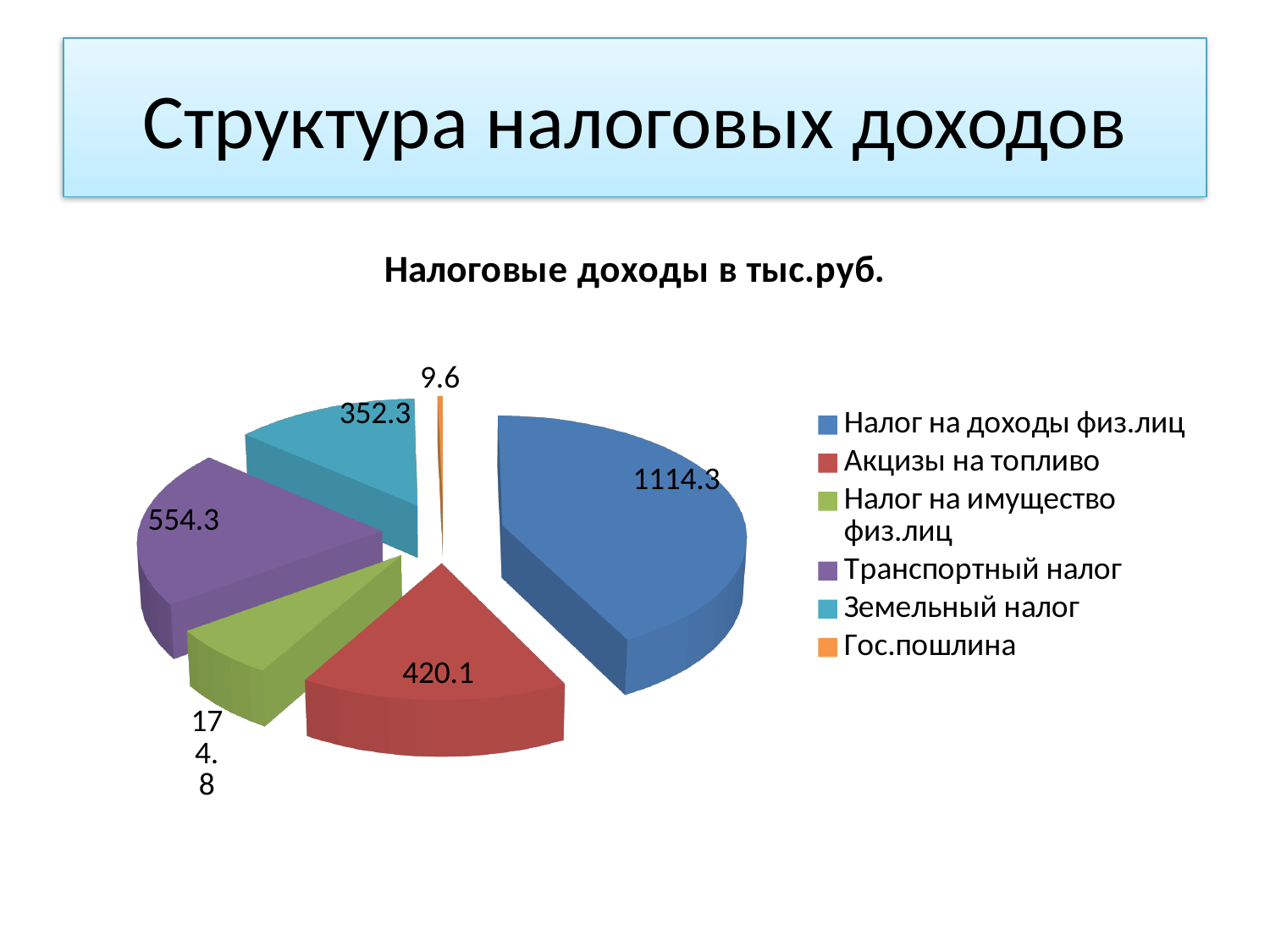
What is the title of the chart? Налоговые доходы в тыс.руб. How many categories does the legend list? 6 Which is larger, Транспортный налог or Земельный налог? Транспортный налог What is the value for Транспортный налог? 554.3 What is the value for Акцизы на топливо? 420.1 What is the value for Гос.пошлина? 9.6 What is the value for Налог на доходы физ.лиц? 1114.3 What kind of chart is shown on the slide? pie chart What is the difference between Налог на доходы физ.лиц and Акцизы на топливо? 694.2 What is the value for Земельный налог? 352.3 Which category has the smallest value? Гос.пошлина Which category has the largest value? Налог на доходы физ.лиц